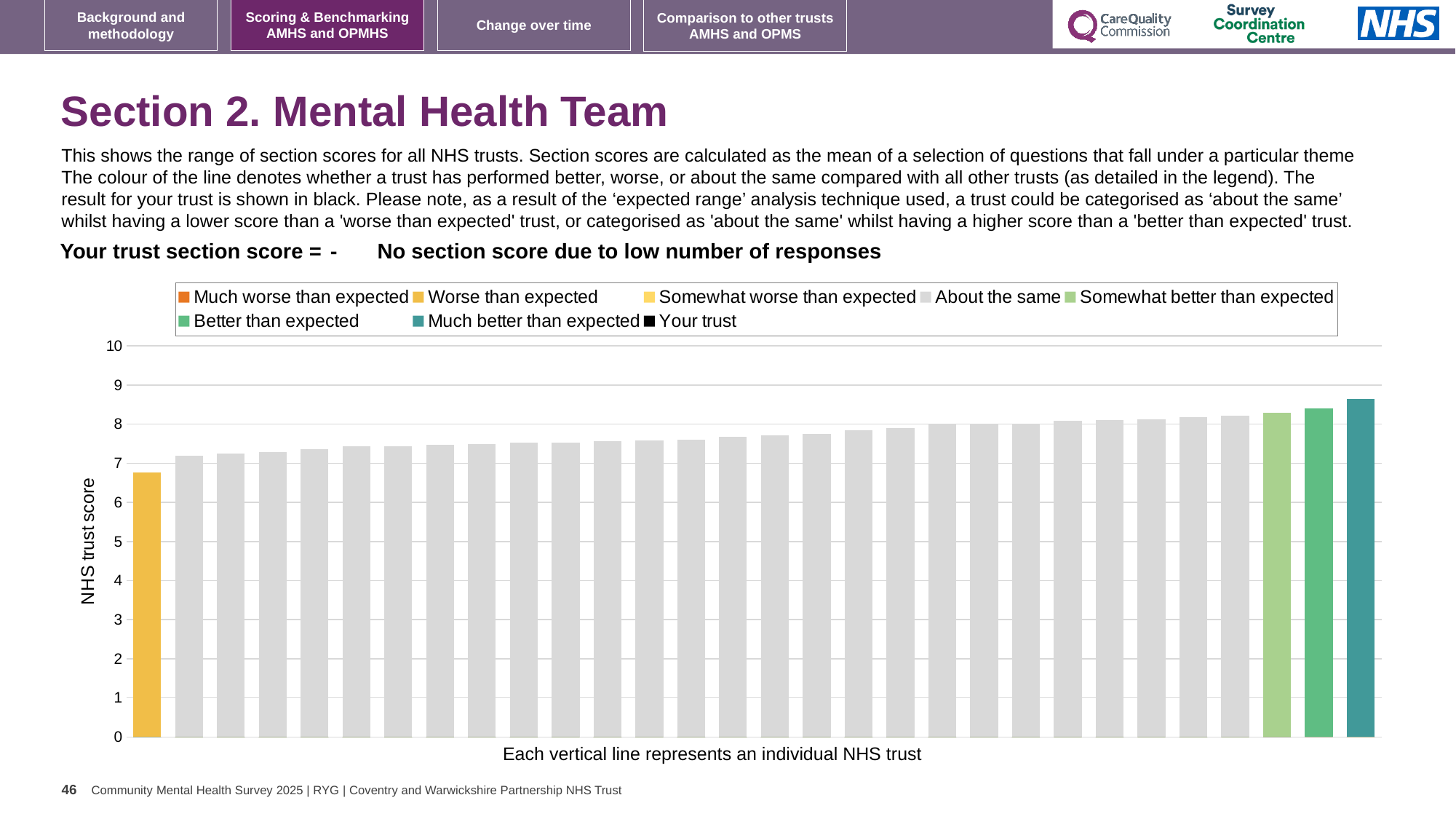
Which is larger, the leftmost bar or the rightmost bar? the rightmost bar What kind of chart is shown on the slide? bar chart Is the value of the rightmost (teal) bar greater or less than 8? greater Is the value of the leftmost bar greater or less than 6? greater What is the label on the vertical axis of the chart? NHS trust score What is the trust section score shown above the chart? No section score due to low number of responses Do the bar values rise or fall from left to right along the x axis? rise Which legend category does the highest bar belong to? Much better than expected Is the value of the rightmost bar greater or less than 9? less Which legend category does the lowest bar belong to? Worse than expected How many entries does the chart legend list? 8